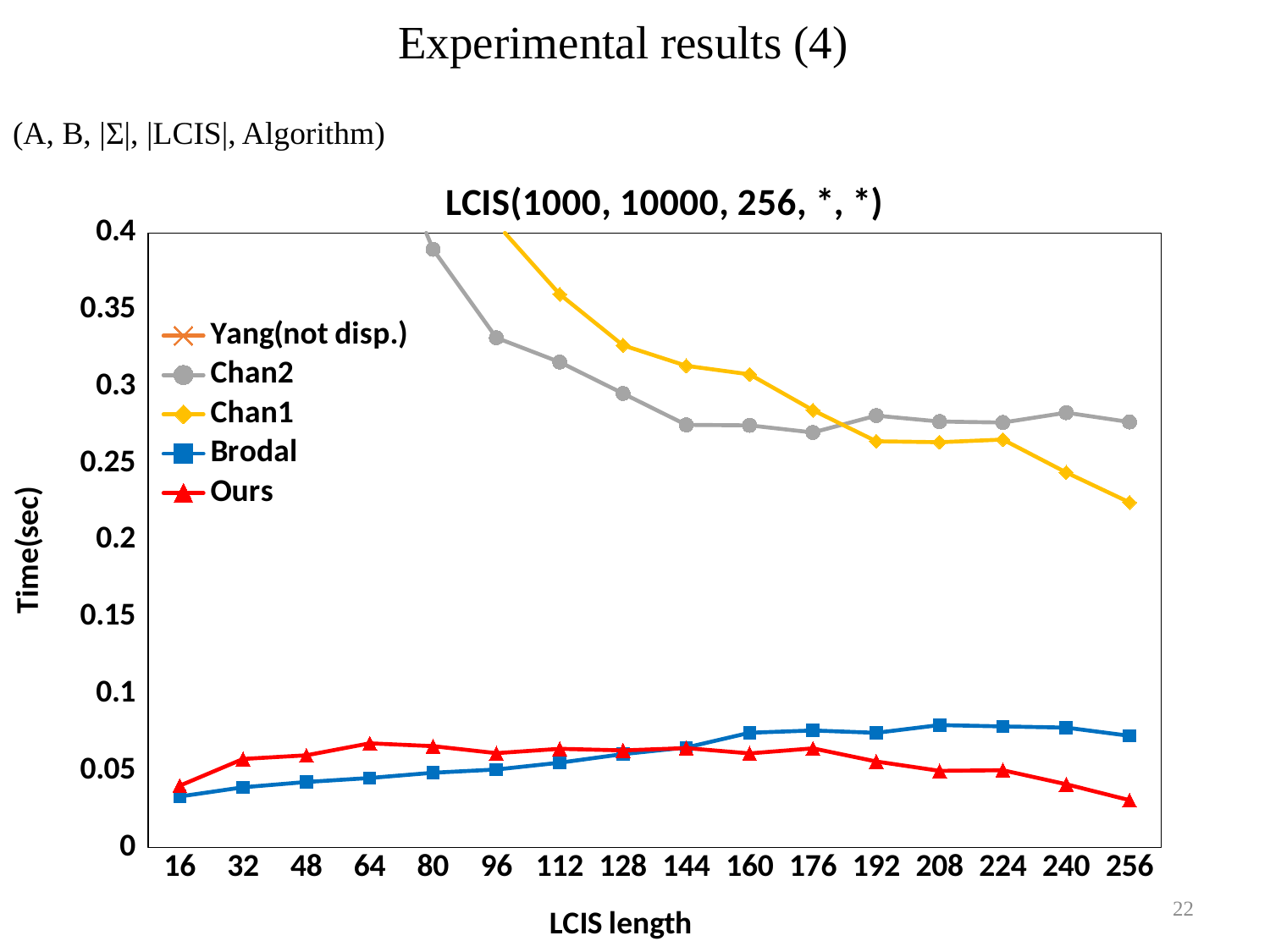
How many LCIS length values are marked on the x axis? 16 Is the value for Chan2 at LCIS length 80 greater or less than 0.35? greater What kind of chart is shown on the slide? line chart What is the label of the y axis? Time(sec) Is the value for Brodal at LCIS length 16 greater or less than 0.05? less At LCIS length 96, which is larger, Chan1 or Chan2? Chan1 At LCIS length 256, which is larger, Brodal or Ours? Brodal What is the title of the chart? LCIS(1000, 10000, 256, *, *) How many series does the legend list? 5 Is the value for Ours at LCIS length 256 greater or less than 0.05? less Does the Chan1 series rise or fall as LCIS length increases? fall